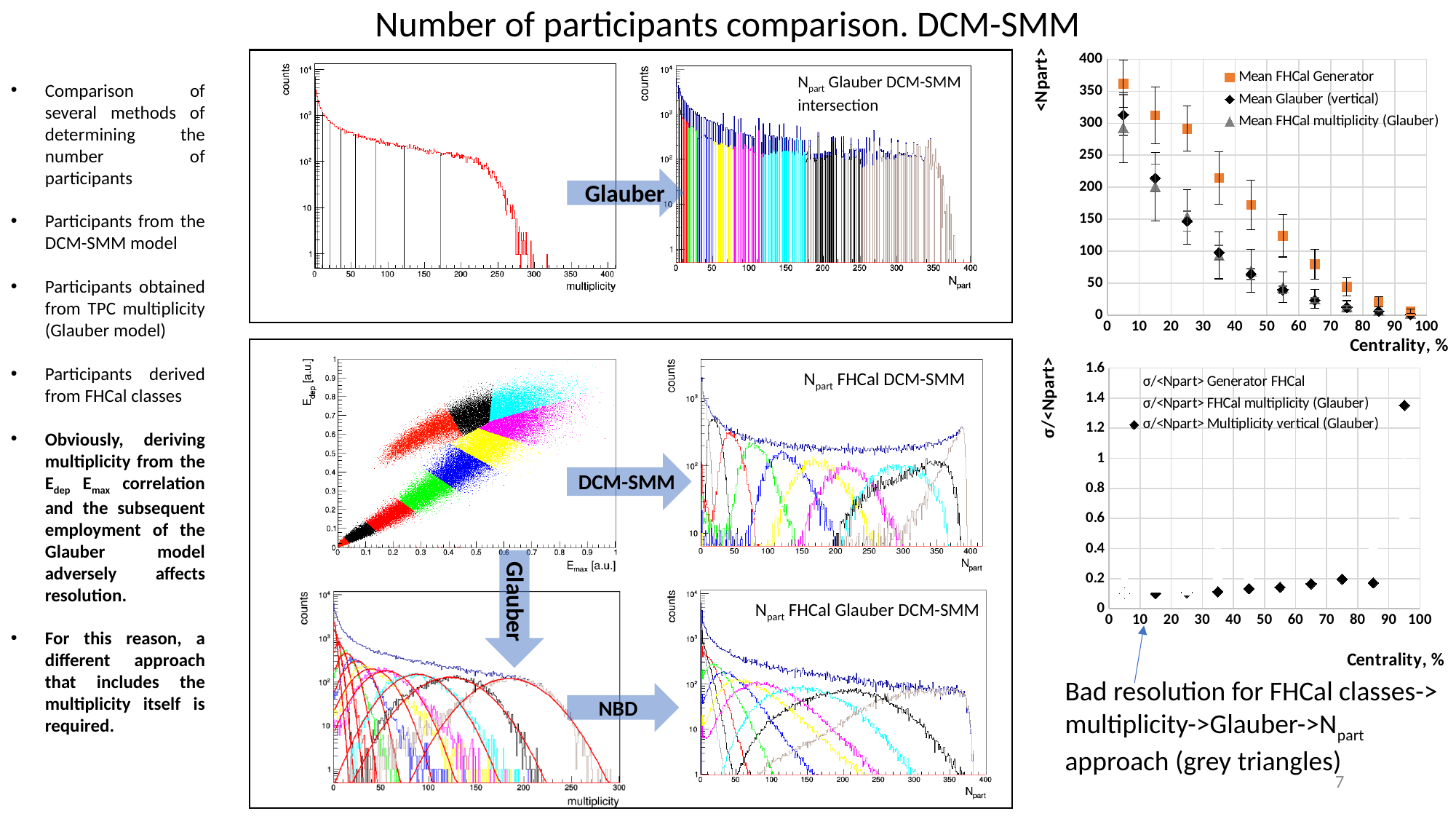
In the top-right chart (<Npart> vs Centrality), is the Mean FHCal Generator value at 95% centrality greater or less than 50? less In the bottom-right chart (σ/<Npart> vs Centrality), is the σ/<Npart> Multiplicity vertical (Glauber) value at 95% centrality greater or less than 1.2? greater What is the x-axis title of the top-right chart (<Npart> vs Centrality)? Centrality, % What kind of chart is the top-right chart plotting <Npart> against Centrality? scatter chart In the bottom-right chart (σ/<Npart> vs Centrality), at which centrality is the σ/<Npart> Multiplicity vertical (Glauber) value highest? 95% In the top-right chart (<Npart> vs Centrality), how many series does the legend list? 3 In the bottom-right chart (σ/<Npart> vs Centrality), how many series does the legend list? 3 In the top-right chart (<Npart> vs Centrality), which series has the larger value at 25% centrality: Mean FHCal Generator or Mean Glauber (vertical)? Mean FHCal Generator In the top-right chart (<Npart> vs Centrality), is the Mean FHCal Generator value at 45% centrality greater or less than 150? greater In the top-right chart (<Npart> vs Centrality), how many Mean FHCal Generator points are plotted? 10 In the top-right chart (<Npart> vs Centrality), do the Mean FHCal Generator values rise or fall as centrality increases? fall